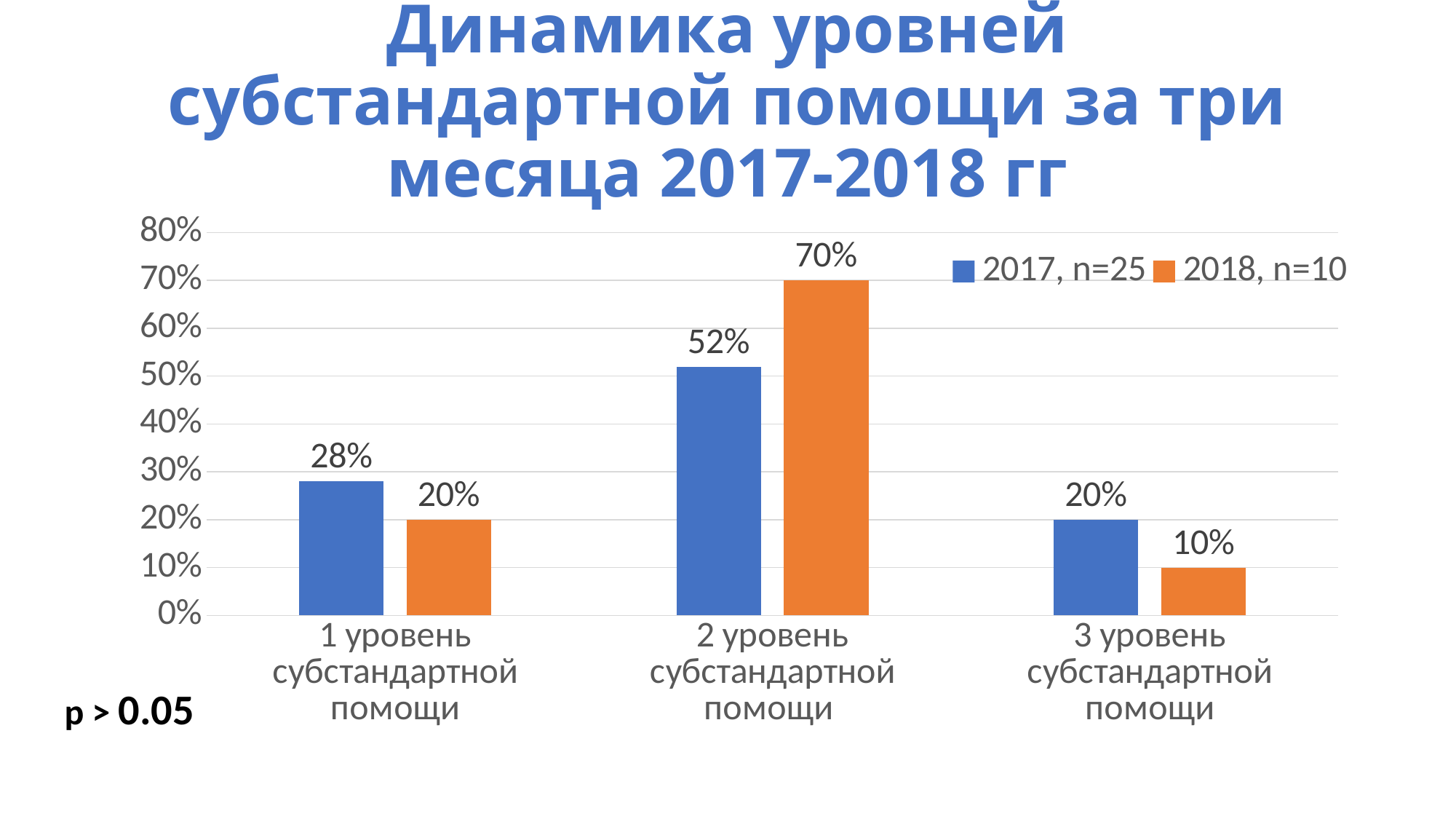
How many series does the legend list? 2 What is the value for "2017, n=25" at "2 уровень субстандартной помощи"? 52% What kind of chart is shown on the slide? bar chart What is the difference between the "2018, n=10" and "2017, n=25" values at "2 уровень субстандартной помощи"? 18% What is the value for "2018, n=10" at "3 уровень субстандартной помощи"? 10% Is the value for "2017, n=25" at "2 уровень субстандартной помощи" greater or less than 50%? greater Which category has the lowest value for the "2017, n=25" series? 3 уровень субстандартной помощи Which category has the highest value for the "2018, n=10" series? 2 уровень субстандартной помощи What is the value for "2018, n=10" at "1 уровень субстандартной помощи"? 20% How many categories are shown on the x axis? 3 What colour are the bars for the "2018, n=10" series? orange At "1 уровень субстандартной помощи", which series has the larger value, "2017, n=25" or "2018, n=10"? 2017, n=25